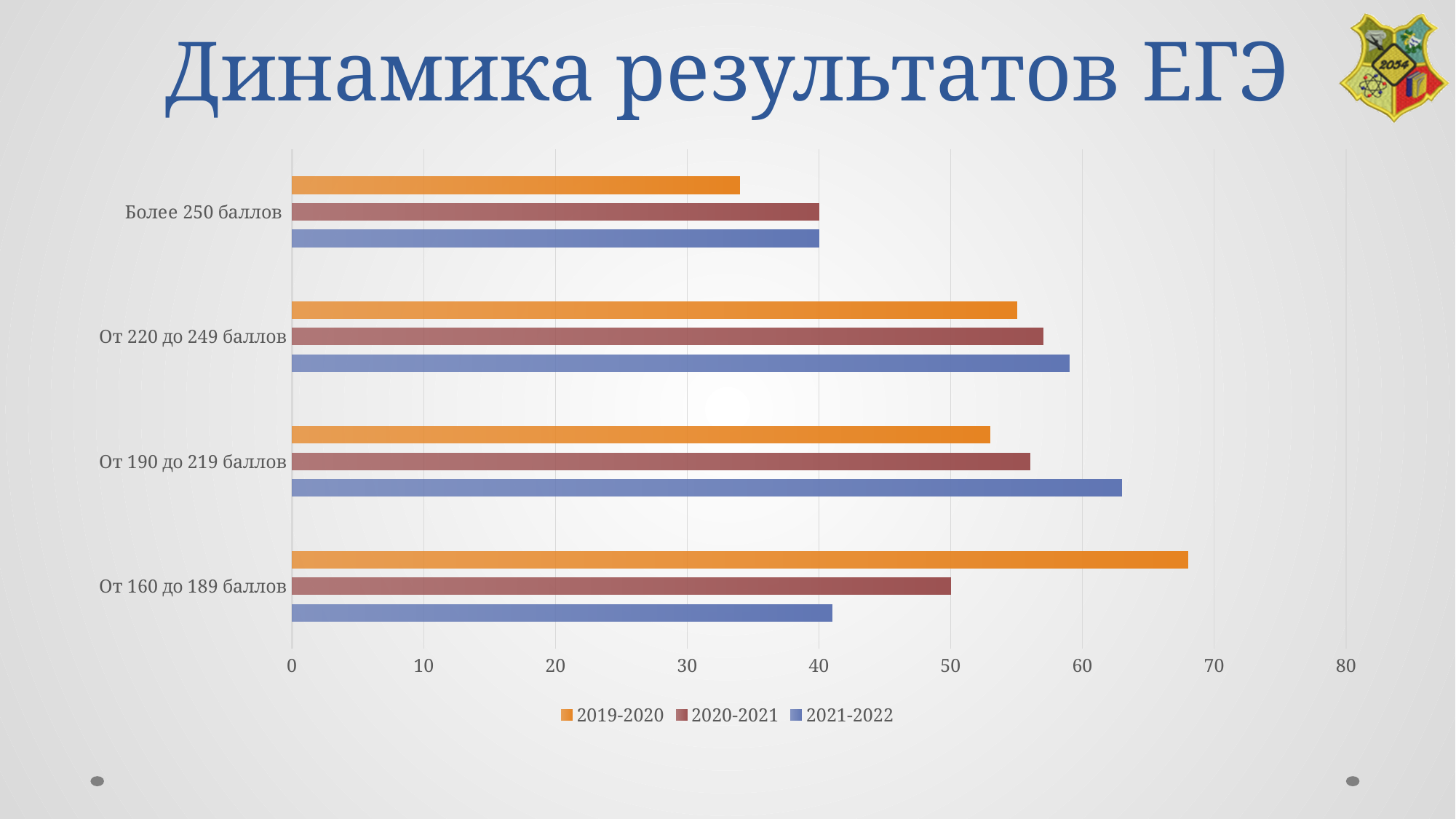
What is the value for 2020-2021 in the category 'От 160 до 189 баллов'? 50 Is the value for 2019-2020 in 'Более 250 баллов' greater or less than 40? less Which series is shown in orange in the legend? 2019-2020 What kind of chart is shown on the slide? bar chart What is the value for 2020-2021 in the category 'Более 250 баллов'? 40 What is the title of the slide? Динамика результатов ЕГЭ In the category 'От 190 до 219 баллов', which is larger: the value for 2019-2020 or for 2021-2022? 2021-2022 Which series has the highest value in the category 'От 160 до 189 баллов'? 2019-2020 Is the value for 2021-2022 in 'От 190 до 219 баллов' greater or less than 60? greater Is the value for 2019-2020 in 'От 160 до 189 баллов' greater or less than 60? greater How many score categories are shown on the chart? 4 How many series does the legend list? 3